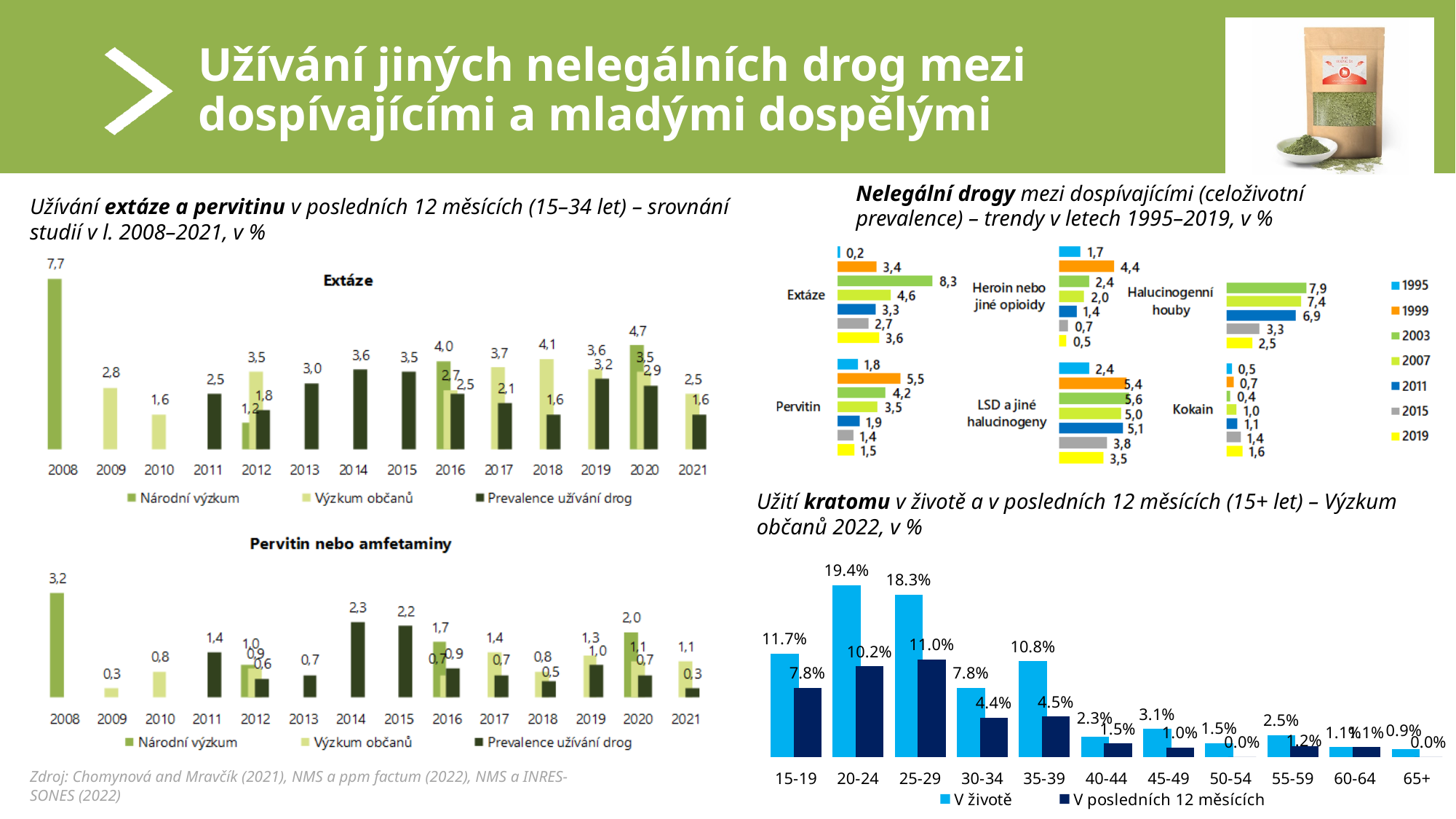
In the Extáze chart, what is the Národní výzkum value for 2008? 7,7 In the Užití kratomu chart, how many age groups are shown on the x axis? 11 In the Užití kratomu chart, what is the V životě value for the 20-24 age group? 19.4% In the Nelegální drogy mezi dospívajícími chart, what is the Extáze value for 2003? 8,3 In the Extáze chart, what is the difference between the Výzkum občanů value and the Prevalence užívání drog value in 2020? 0,6 In the Pervitin nebo amfetaminy chart, what is the Prevalence užívání drog value for 2014? 2,3 In the Nelegální drogy mezi dospívajícími chart, what kind of chart is used? bar chart In the Extáze chart, which year has the highest Národní výzkum value after 2008? 2020 In the Užití kratomu chart, is the V životě value for 35-39 larger or smaller than the V životě value for 30-34? larger In the Pervitin nebo amfetaminy chart, how many series does the legend list? 3 In the Pervitin nebo amfetaminy chart, which year has the lowest Výzkum občanů value? 2009 In the Užití kratomu chart, which age group has the highest V posledních 12 měsících value? 25-29